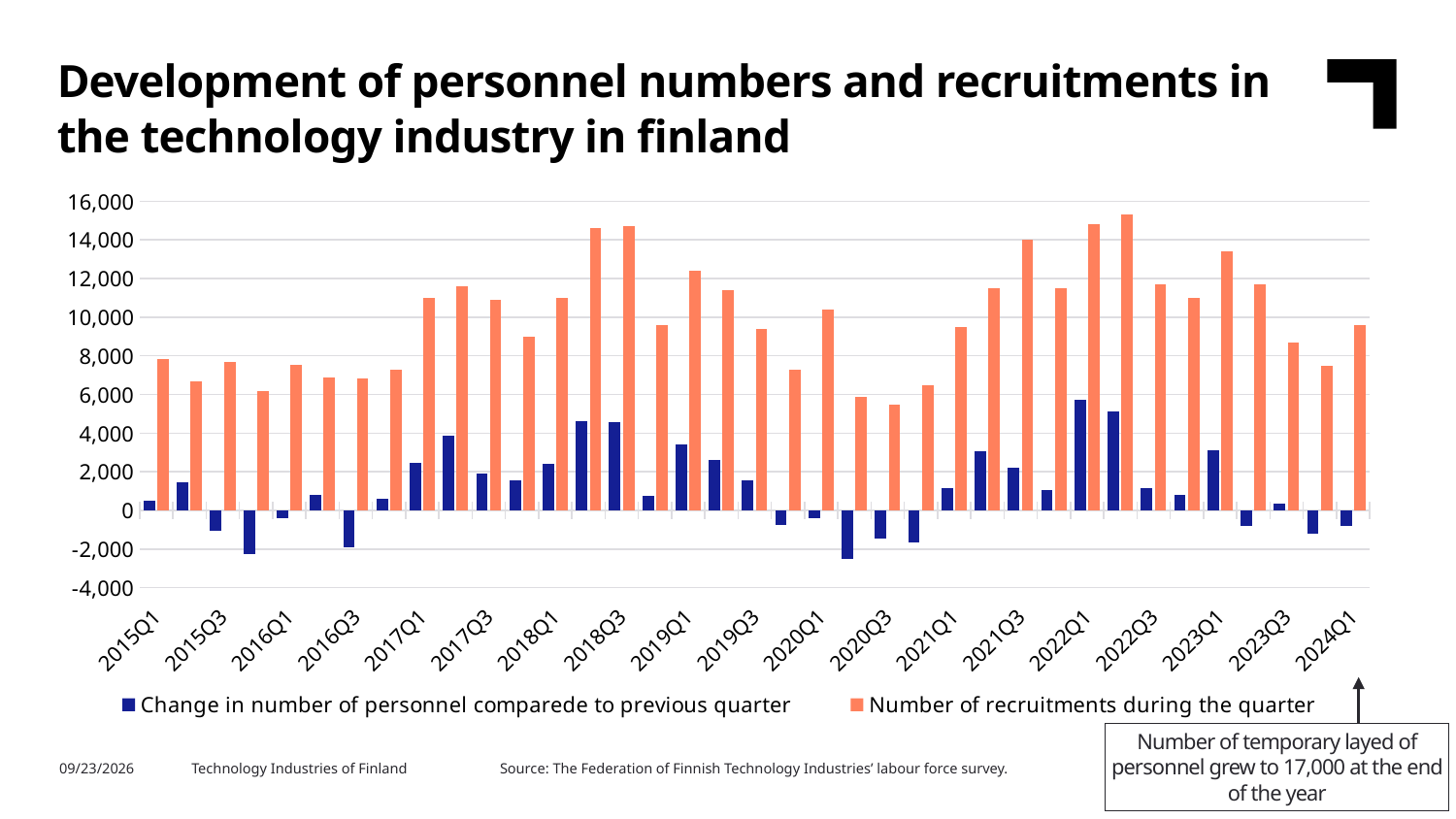
Is the number of recruitments in 2017Q1 greater or less than 10,000? greater Which colour represents the number of recruitments during the quarter? Orange Which quarter had more recruitments, 2018Q3 or 2015Q1? 2018Q3 How many series does the legend list? 2 What kind of chart is shown on the slide? Bar chart Which quarter had a larger change in number of personnel, 2022Q1 or 2015Q1? 2022Q1 Is the number of recruitments in 2024Q1 greater or less than 10,000? less Is the number of recruitments in 2020Q3 greater or less than 6,000? less What are the two series named in the legend? Change in number of personnel comparede to previous quarter; Number of recruitments during the quarter